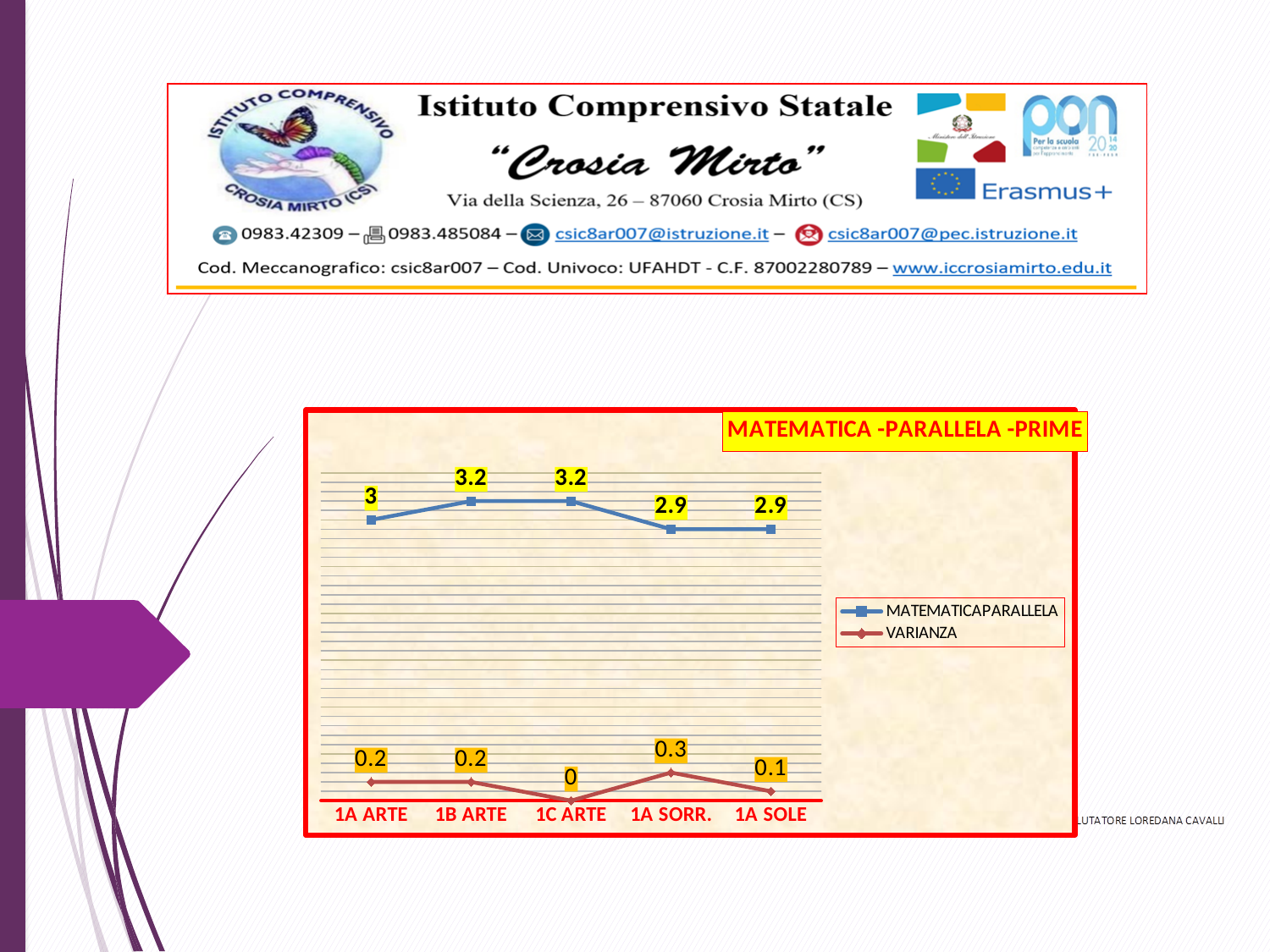
What is the title of the chart? MATEMATICA -PARALLELA -PRIME Does the MATEMATICAPARALLELA series rise or fall from 1C ARTE to 1A SORR.? Fall How many categories are shown on the x axis? 5 What type of chart is shown on the slide? Line chart What is the MATEMATICAPARALLELA value for 1B ARTE? 3.2 Which is larger, the MATEMATICAPARALLELA value for 1A ARTE or for 1A SORR.? 1A ARTE Which category has the lowest VARIANZA value? 1C ARTE What is the difference between the MATEMATICAPARALLELA values for 1B ARTE and 1A SOLE? 0.3 What is the MATEMATICAPARALLELA value for 1A ARTE? 3 What is the VARIANZA value for 1A SORR.? 0.3 Which category has the highest VARIANZA value? 1A SORR. How many series does the legend list? 2